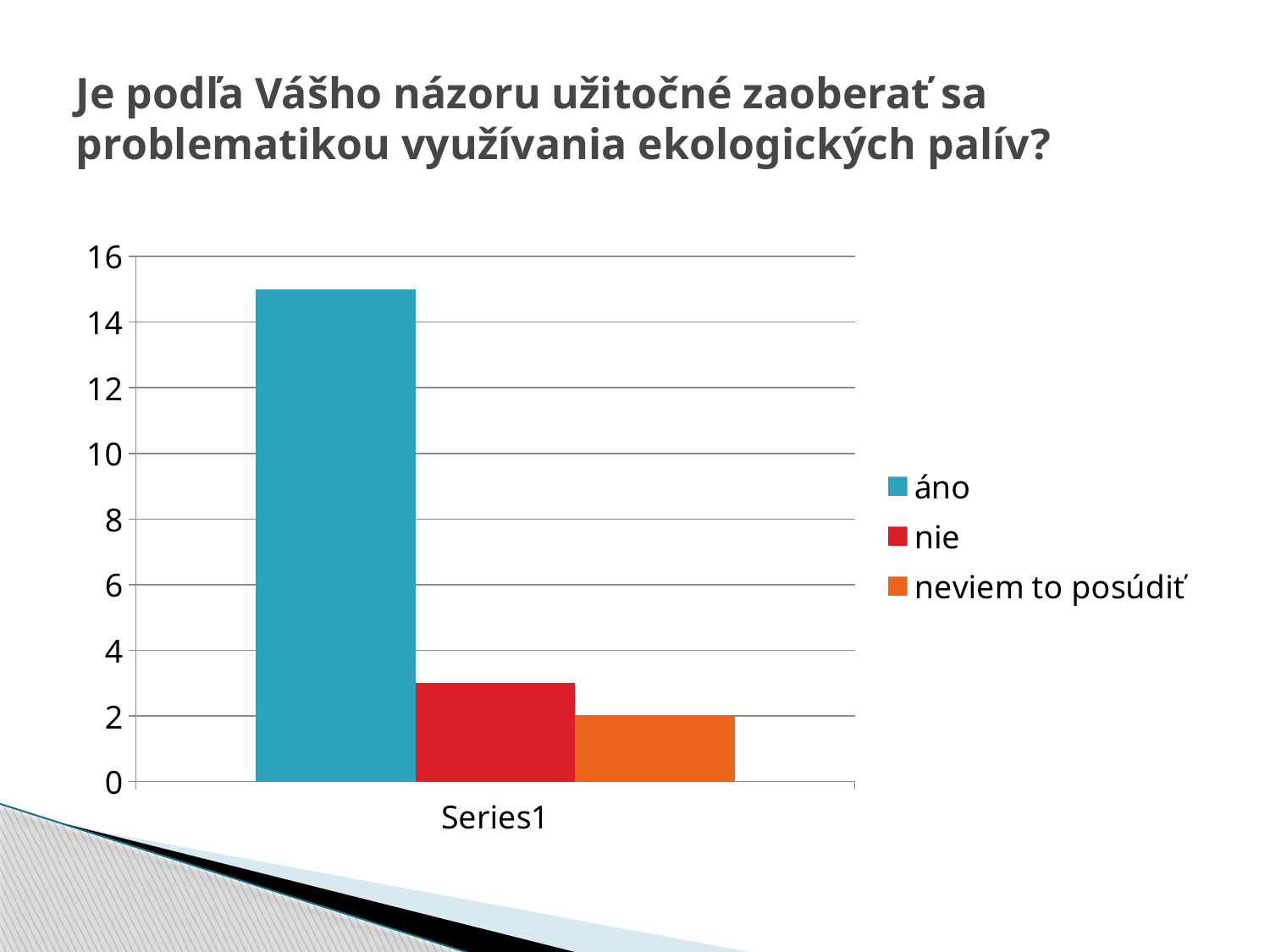
What is the label shown on the x axis under the bars? Series1 What kind of chart is shown on the slide? bar chart How many series does the legend list? 3 Is the value for áno greater or less than 14? greater Which series has the highest value? áno Which is larger, the value for áno or the value for nie? áno What colour is the bar for áno? blue Which series has the lowest value? neviem to posúdiť What is the value for neviem to posúdiť? 2 Is the value for nie greater or less than 2? greater Which is larger, the value for nie or the value for neviem to posúdiť? nie Is the value for nie greater or less than 4? less